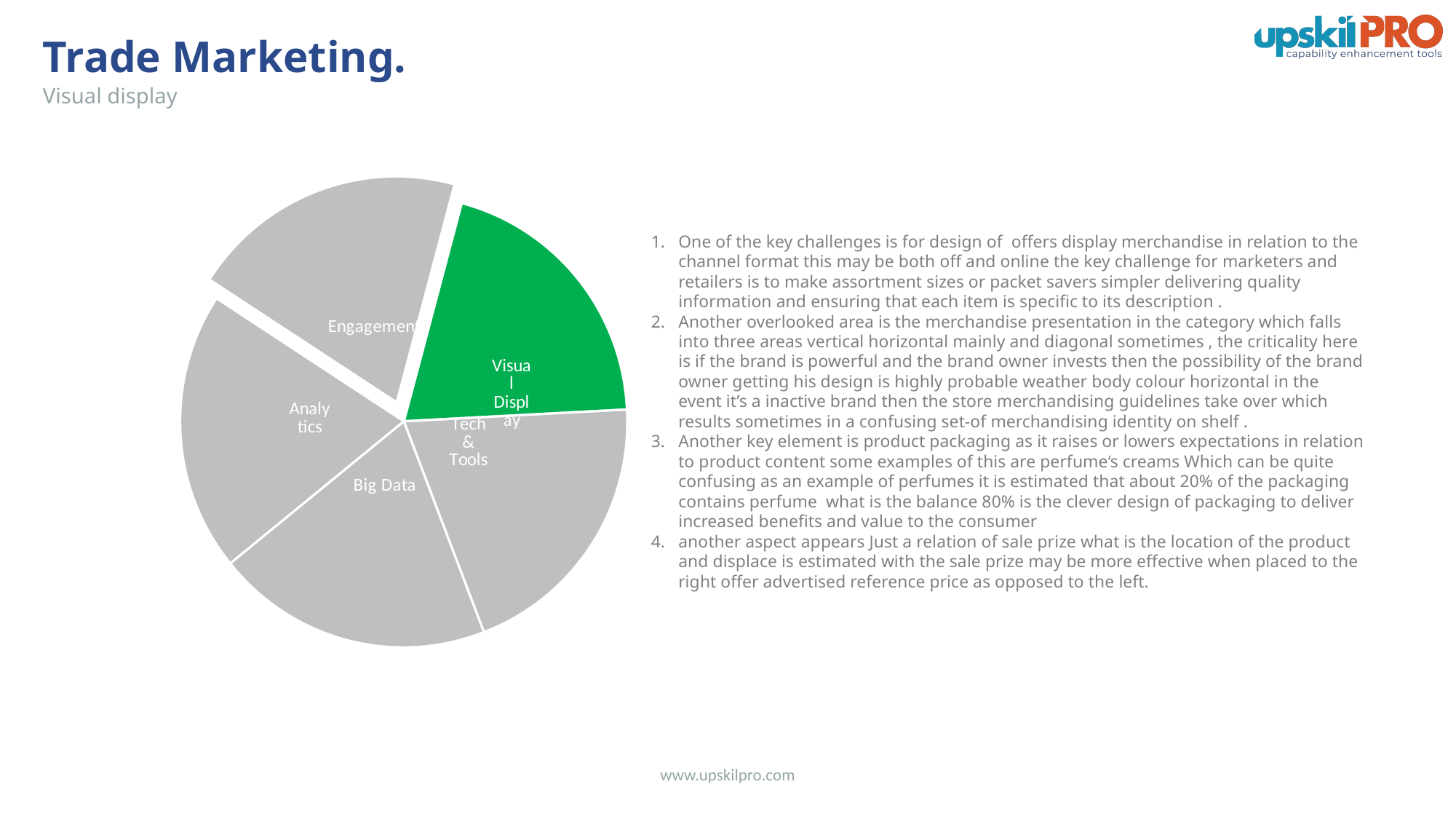
What colour are the slices other than Visual Display in the pie chart? grey How many slices does the pie chart have? 5 Name the five categories shown in the pie chart. Engagement, Visual Display, Tech & Tools, Big Data, Analytics What kind of chart is shown on the slide? pie chart Which slice of the pie chart is coloured green? Visual Display Does the pie chart display numeric data labels on its slices? No